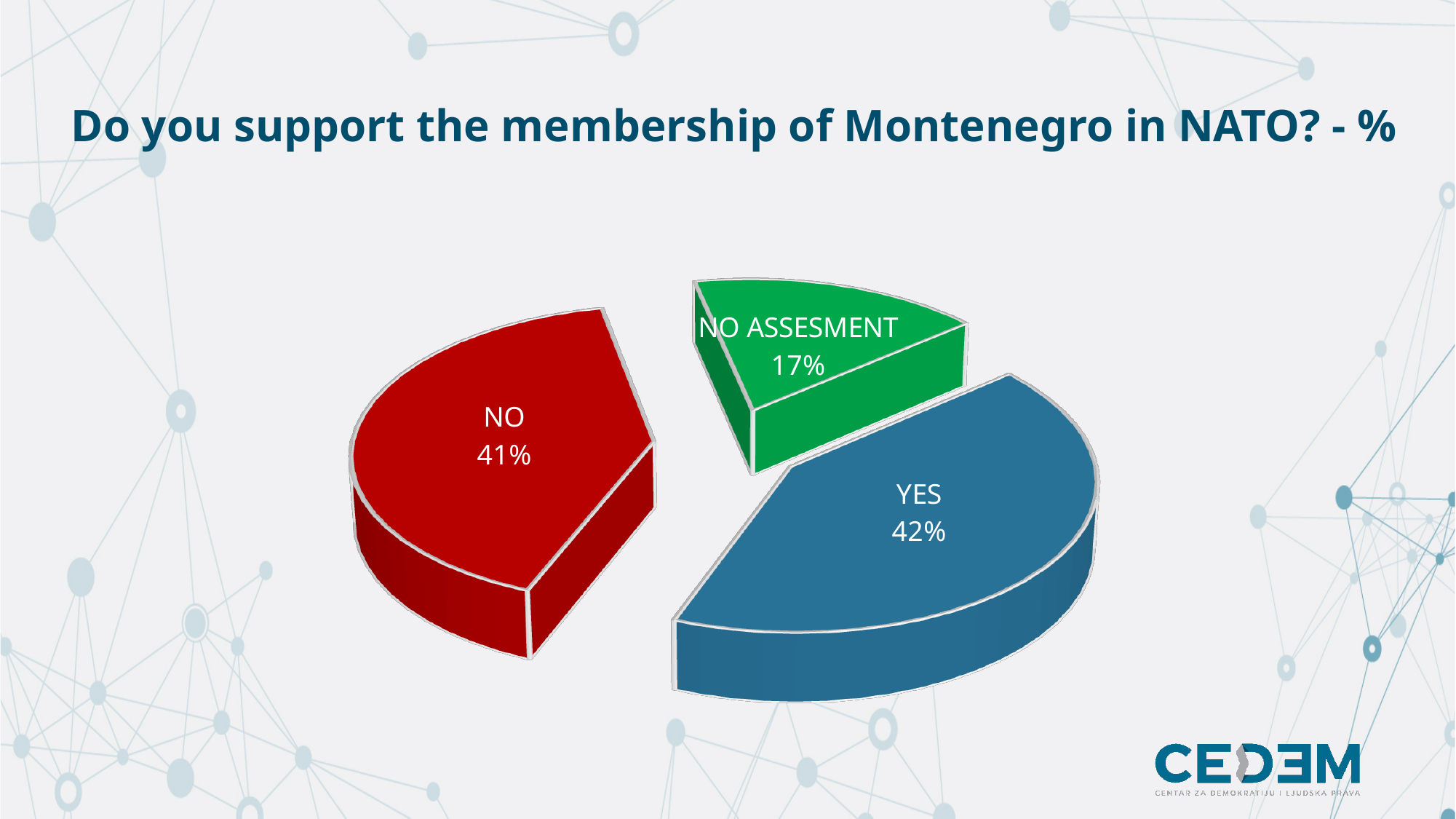
What percentage of respondents answered NO? 41% What is the difference in percentage points between YES and NO ASSESMENT? 25 What percentage of respondents gave NO ASSESMENT? 17% What is the title of the chart? Do you support the membership of Montenegro in NATO? - % What is the difference in percentage points between NO and NO ASSESMENT? 24 How many slices does the pie chart have? 3 What colour is the YES slice? Blue Which response has the largest share of the pie? YES What percentage of respondents answered YES? 42% Which response has the smallest share of the pie? NO ASSESMENT Which is larger, the share for NO or the share for NO ASSESMENT? NO What kind of chart is shown on the slide? Pie chart